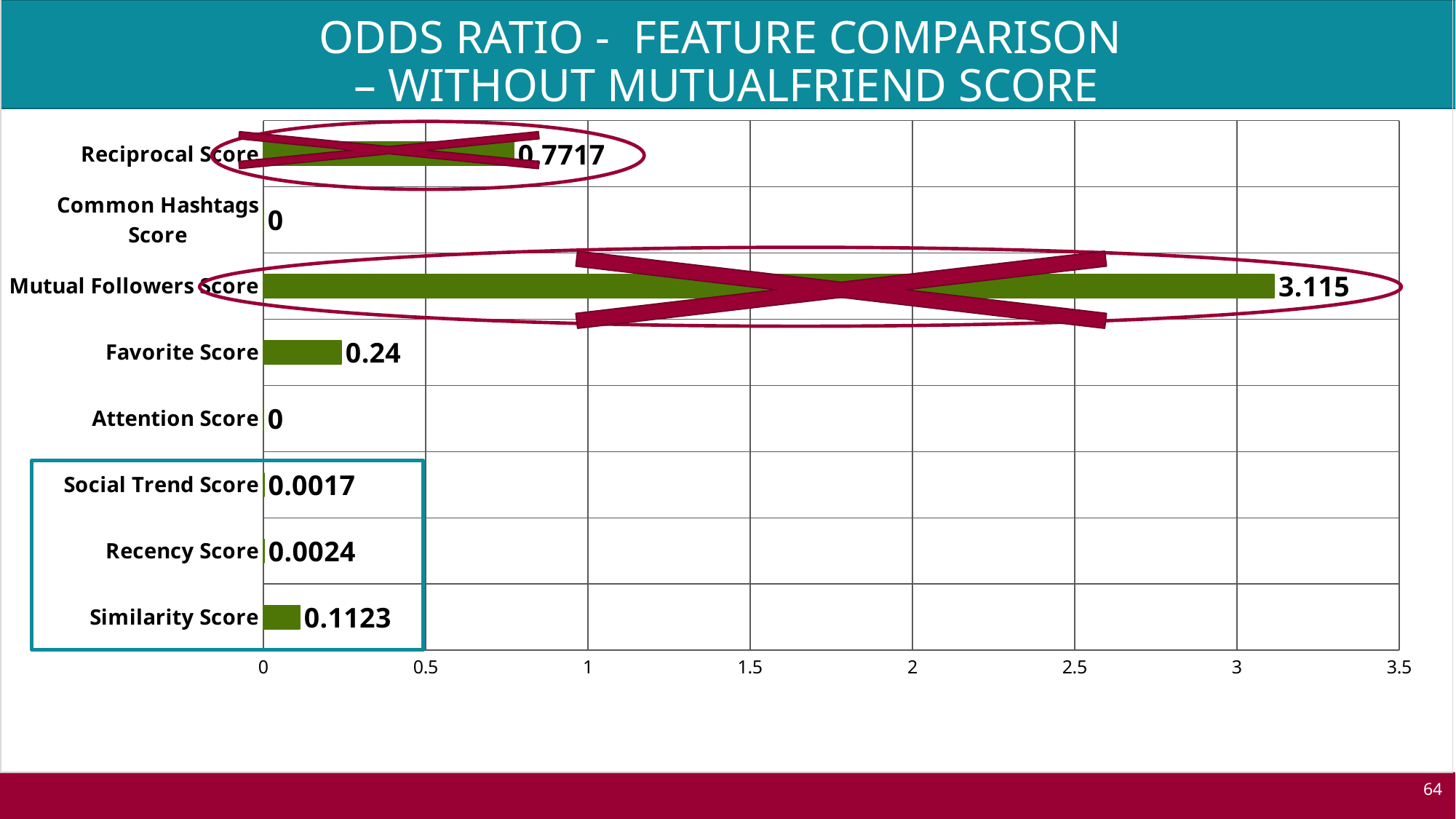
What is the value for Reciprocal Score? 0.7717 Which category has the highest value? Mutual Followers Score What is the value for Similarity Score? 0.1123 What kind of chart is shown on the slide? Bar chart What is the value for Favorite Score? 0.24 Is the value for Mutual Followers Score greater or less than 3? greater What is the value for Mutual Followers Score? 3.115 Which is larger, Favorite Score or Similarity Score? Favorite Score What is the difference between the Mutual Followers Score and the Reciprocal Score? 2.3433 Which two categories have a value of 0? Common Hashtags Score and Attention Score How many categories are shown on the chart? 8 What is the value for Recency Score? 0.0024